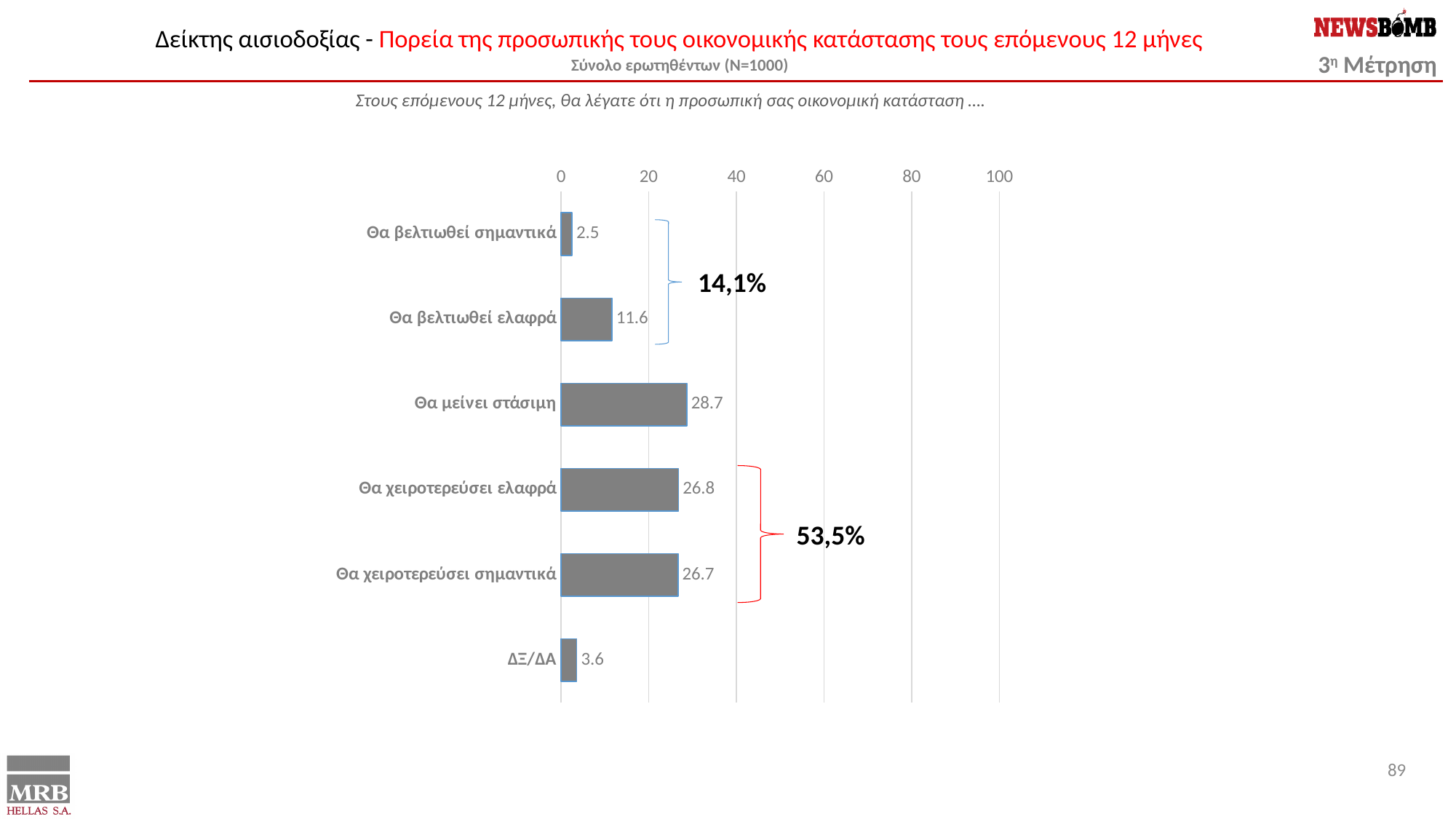
Which category has the lowest value? Θα βελτιωθεί σημαντικά What is the value for "Θα βελτιωθεί ελαφρά"? 11.6 What kind of chart is shown on the slide? bar chart Which category has the highest value? Θα μείνει στάσιμη What is the value for "Θα βελτιωθεί σημαντικά"? 2.5 What percentage is shown next to the red bracket grouping the two "Θα χειροτερεύσει" bars? 53,5% What is the value for "Θα μείνει στάσιμη"? 28.7 What is the difference between the values for "Θα μείνει στάσιμη" and "Θα βελτιωθεί ελαφρά"? 17.1 How many categories are shown in the chart? 6 Is the value for "Θα χειροτερεύσει ελαφρά" greater or less than 20? greater What is the value for "ΔΞ/ΔΑ"? 3.6 Which is larger, the value for "Θα βελτιωθεί ελαφρά" or the value for "ΔΞ/ΔΑ"? Θα βελτιωθεί ελαφρά